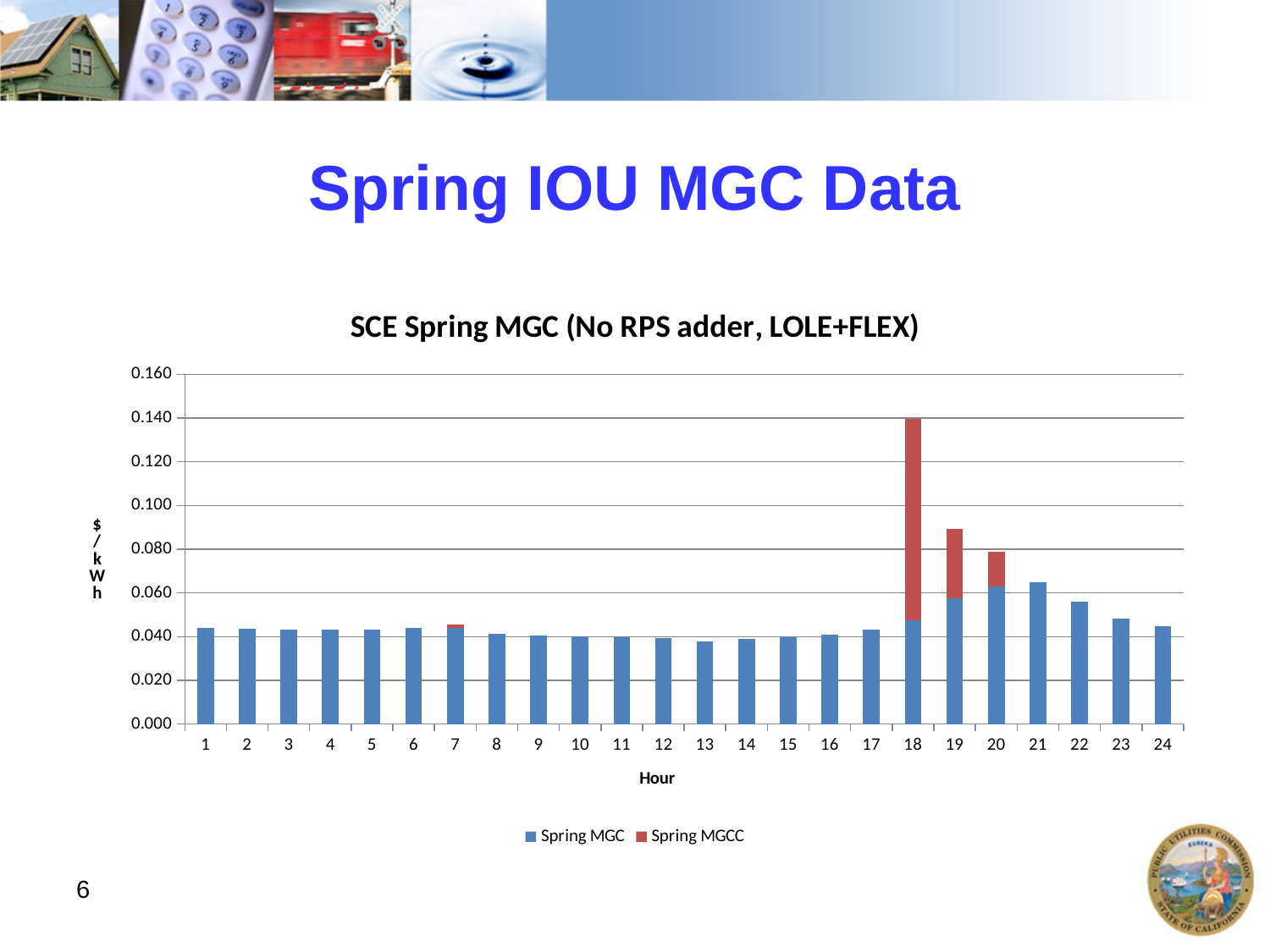
Do the total values rise or fall from hour 18 to hour 24? Fall Which hour has the highest total bar? 18 How many hours are plotted along the x axis? 24 Which is larger, the total bar for hour 18 or for hour 19? Hour 18 Is the value for hour 13 greater or less than 0.040? less Is the total value for hour 19 greater or less than 0.080? greater What kind of chart is shown on the slide? Stacked bar chart Is the total value for hour 18 greater or less than 0.120? greater How many series does the legend list? 2 What is the title of the chart? SCE Spring MGC (No RPS adder, LOLE+FLEX) Which hour has the lowest total bar? 13 Which series is shown in red in the legend? Spring MGCC